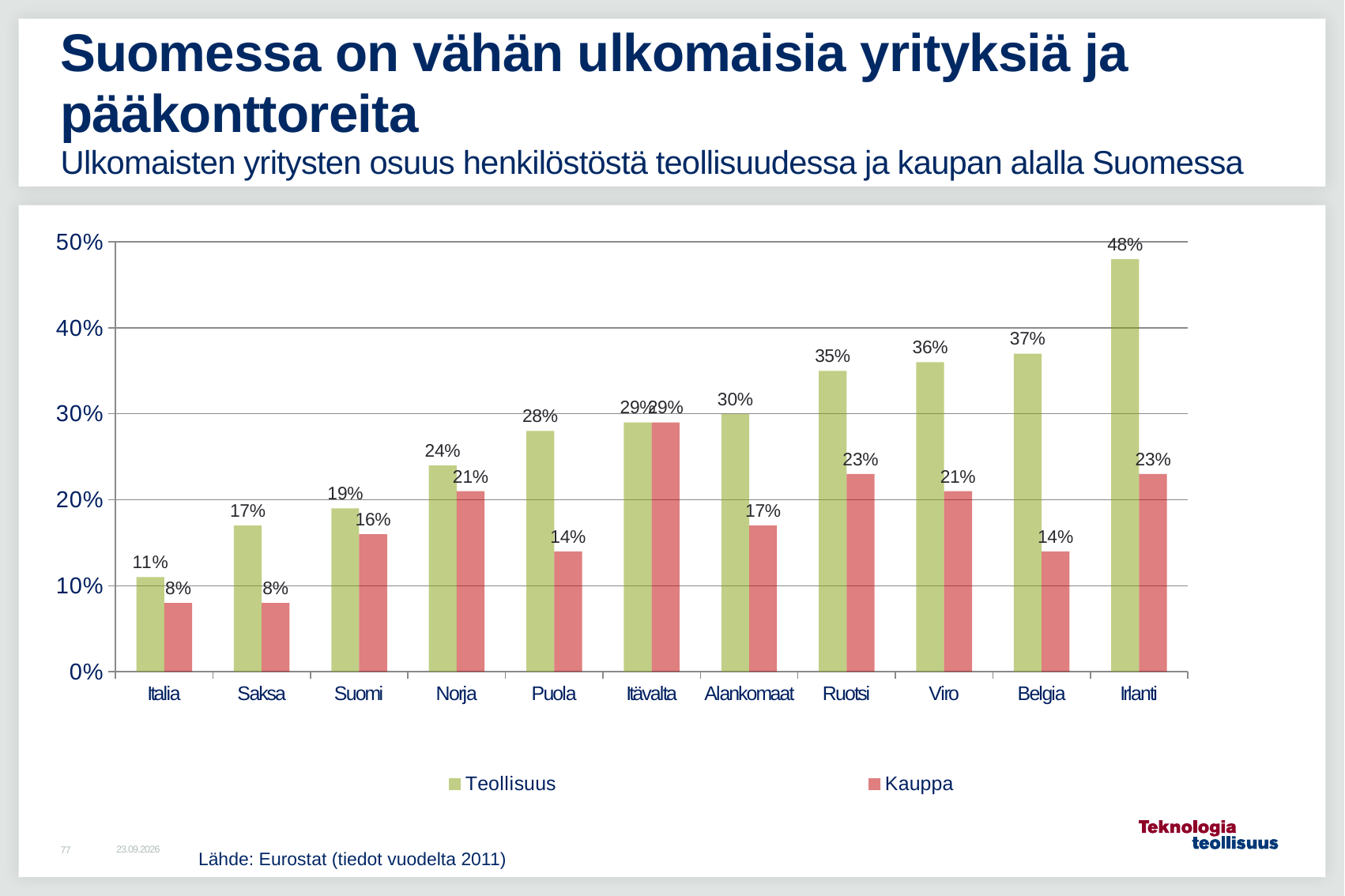
Which country has the highest Teollisuus value? Irlanti Do the Teollisuus values generally rise or fall from Italia to Irlanti? rise What colour are the Kauppa bars? red Which country has the lowest Teollisuus value? Italia How many series does the legend list? 2 What kind of chart is shown on the slide? bar chart What is the Kauppa value for Ruotsi? 23% What is the Teollisuus value for Suomi? 19% Which is larger for Puola, the Teollisuus value or the Kauppa value? Teollisuus How many countries are shown on the x axis? 11 Is the Teollisuus value for Belgia greater or less than 30%? greater What is the difference between the Teollisuus and Kauppa values for Irlanti? 25%